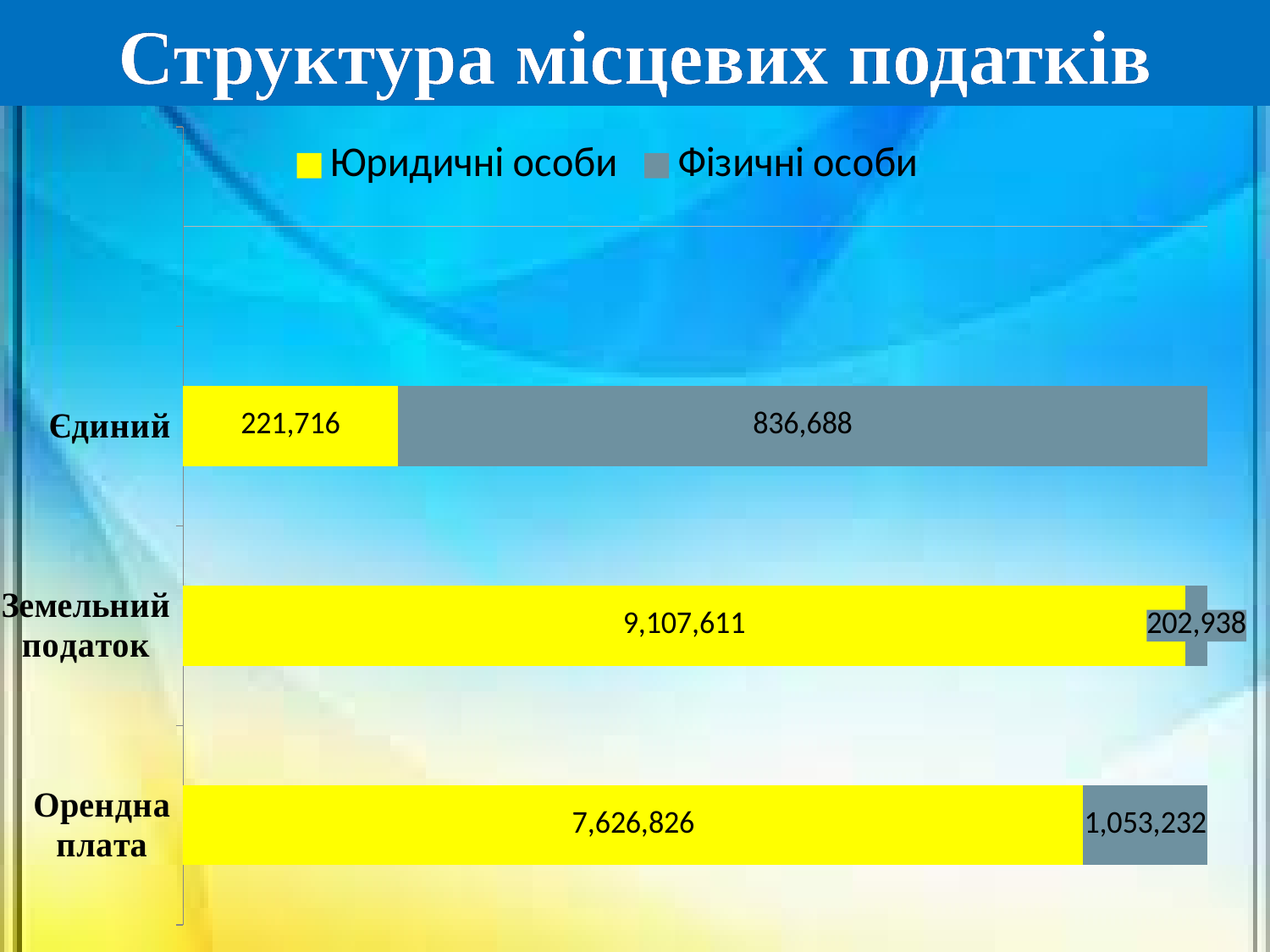
How many categories are shown on the chart? 3 What is the value for Фізичні особи in the Орендна плата category? 1,053,232 What is the value for Юридичні особи in the Земельний податок category? 9,107,611 What is the value for Фізичні особи in the Єдиний category? 836,688 What is the difference between Юридичні особи and Фізичні особи in the Орендна плата category? 6,573,594 What is the total of the Єдиний bar (Юридичні особи plus Фізичні особи)? 1,058,404 Which category has the lowest value for Фізичні особи? Земельний податок Which category has the highest value for Юридичні особи? Земельний податок How many series does the legend list? 2 What type of chart is shown on the slide? Stacked bar chart What is the title of the chart? Структура місцевих податків In the Єдиний category, which is larger: Юридичні особи or Фізичні особи? Фізичні особи